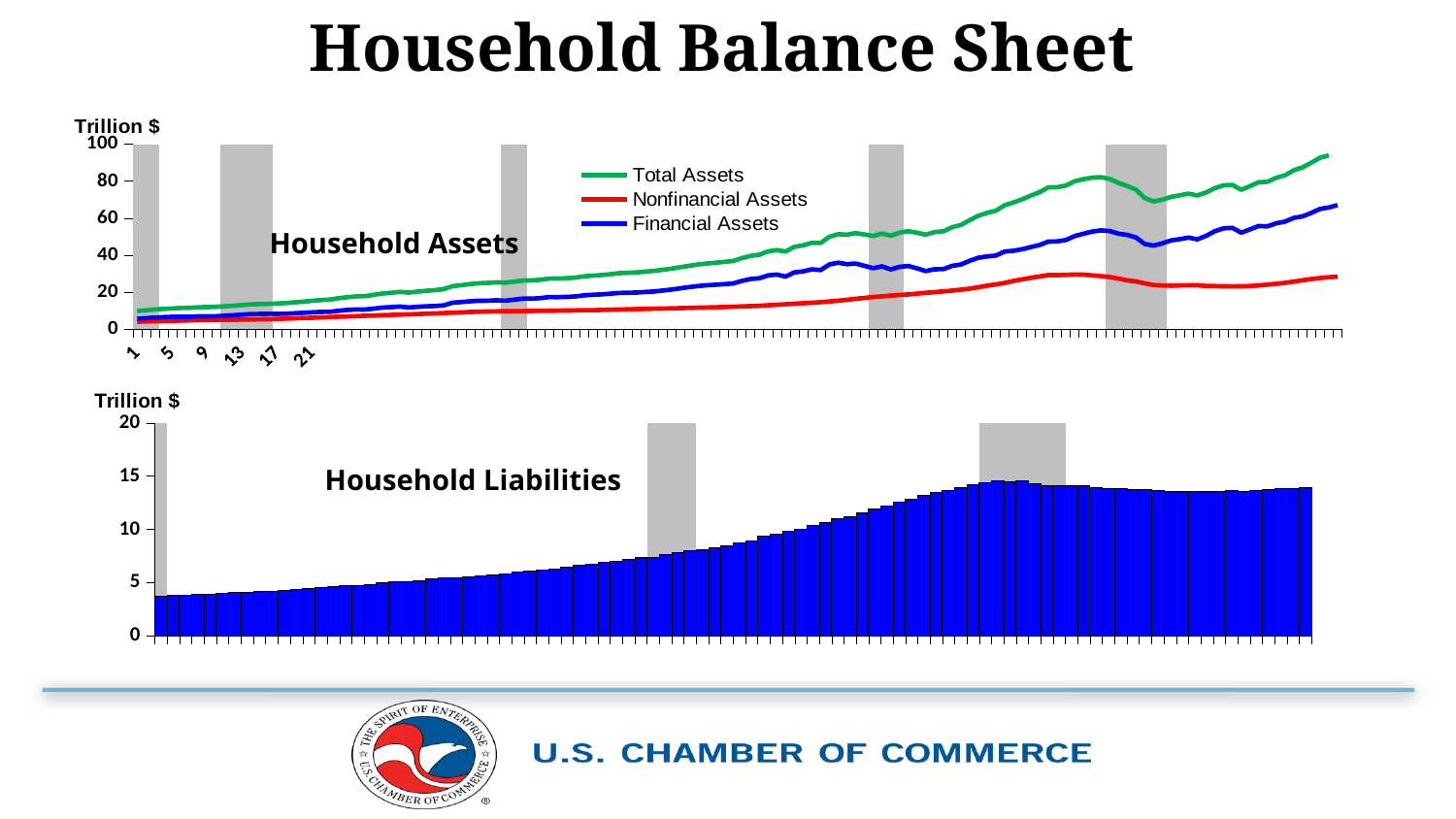
In the Household Liabilities chart, is the highest bar greater or less than 15? less In the Household Assets chart, do the Total Assets values generally rise or fall along the x axis? rise In the Household Assets chart, is the final value of Nonfinancial Assets greater or less than 40? less What unit is shown on the y axis of the Household Liabilities chart? Trillion $ In the Household Assets chart, is the final value of Total Assets greater or less than 80? greater What kind of chart is the Household Assets chart? line chart In the Household Assets chart, which series has the lowest values throughout? Nonfinancial Assets In the Household Assets chart, which series has the highest values throughout? Total Assets How many series does the legend of the Household Assets chart list? 3 What kind of chart is the Household Liabilities chart? bar chart